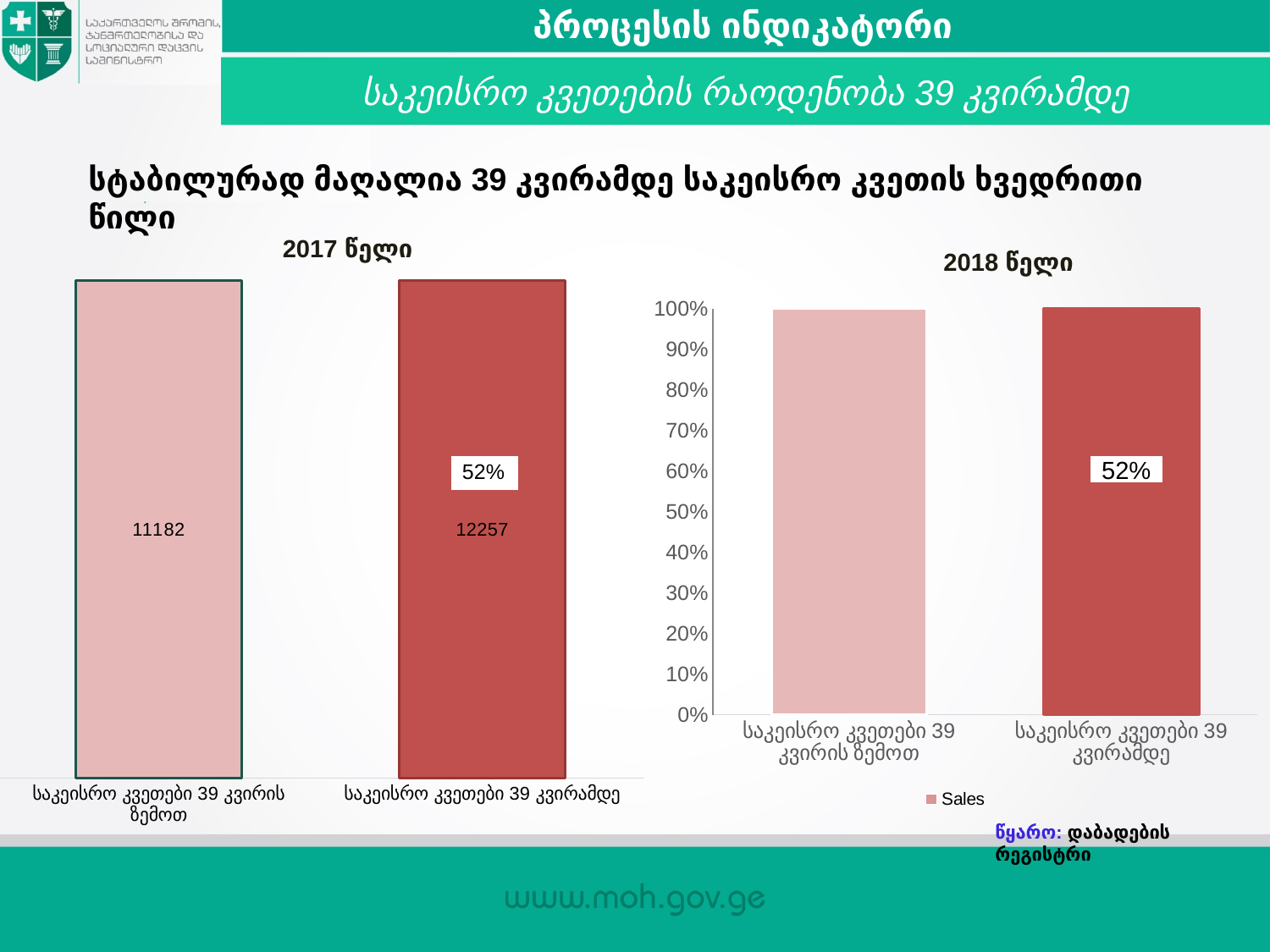
In the 2017 წელი chart, which category has the larger printed value, საკეისრო კვეთები 39 კვირის ზემოთ or საკეისრო კვეთები 39 კვირამდე? საკეისრო კვეთები 39 კვირამდე What kind of chart is the 2018 წელი chart? bar chart In the 2017 წელი chart, what percentage label is shown on the საკეისრო კვეთები 39 კვირამდე bar? 52% How many series does the legend of the 2018 წელი chart list? 1 In the 2017 წელი chart, what value is printed on the bar for საკეისრო კვეთები 39 კვირის ზემოთ? 11182 In the 2017 წელი chart, what value is printed on the bar for საკეისრო კვეთები 39 კვირამდე? 12257 How many categories are shown in the 2017 წელი chart? 2 In the 2018 წელი chart, what is the highest value shown on the vertical axis? 100% In the 2017 წელი chart, what is the difference between the values 12257 and 11182? 1075 What is the legend entry in the 2018 წელი chart? Sales How many categories are shown on the x axis of the 2018 წელი chart? 2 In the 2018 წელი chart, what percentage label is shown on the საკეისრო კვეთები 39 კვირამდე bar? 52%